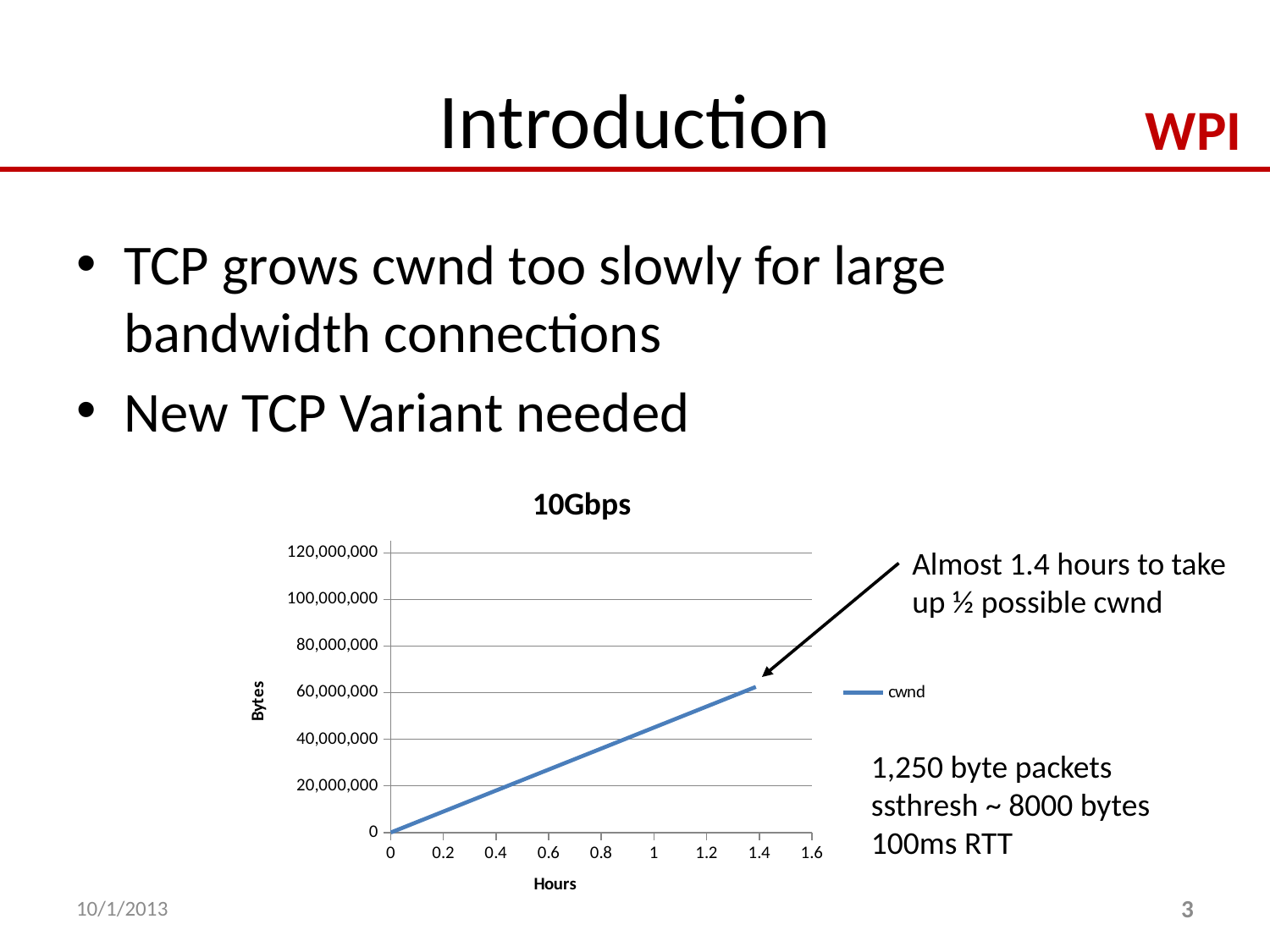
Is the cwnd value at 1 hour greater or less than 60,000,000? less What is the name of the series shown in the chart legend? cwnd Does the cwnd value rise or fall as hours increase along the x axis? rise Is the cwnd value at 1.2 hours greater or less than 80,000,000? less What is the highest value shown on the y axis of the chart? 120,000,000 What kind of chart is shown on the slide? line chart How many series does the chart legend list? 1 Is the cwnd value at 1 hour greater or less than 40,000,000? greater What is the title of the chart? 10Gbps